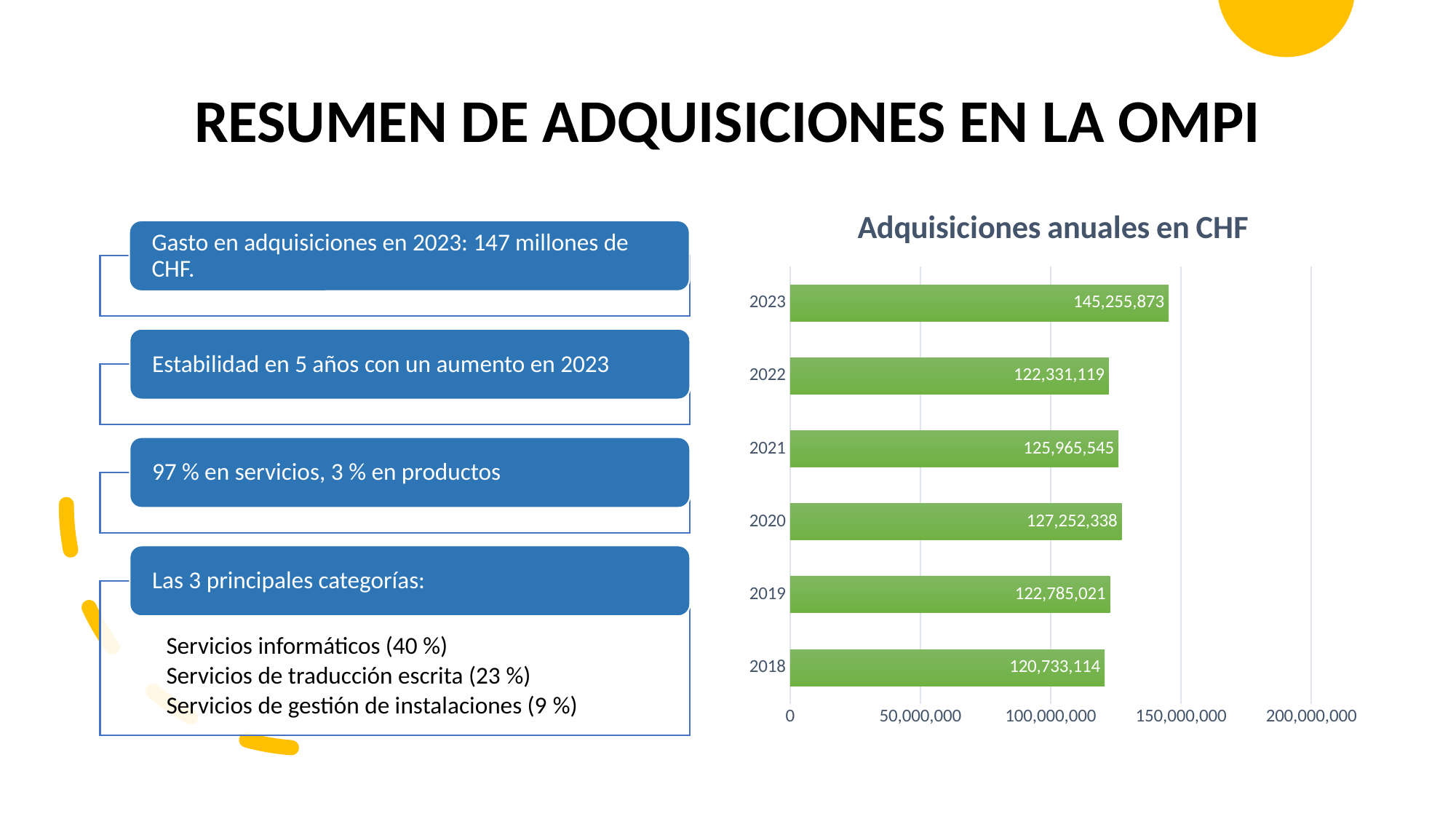
Which year has the lowest value in the "Adquisiciones anuales en CHF" chart? 2018 In the "Adquisiciones anuales en CHF" chart, which is larger, the value for 2021 or the value for 2019? 2021 What is the title of the chart on the slide? Adquisiciones anuales en CHF Which year has the highest value in the "Adquisiciones anuales en CHF" chart? 2023 What is the value for 2018 in the "Adquisiciones anuales en CHF" chart? 120,733,114 What is the difference between the 2023 and 2022 values in the "Adquisiciones anuales en CHF" chart? 22,924,754 How many years are shown in the "Adquisiciones anuales en CHF" chart? 6 What is the value for 2020 in the "Adquisiciones anuales en CHF" chart? 127,252,338 What type of chart is shown under the title "Adquisiciones anuales en CHF"? bar chart What is the difference between the 2020 and 2018 values in the "Adquisiciones anuales en CHF" chart? 6,519,224 What is the value for 2023 in the "Adquisiciones anuales en CHF" chart? 145,255,873 Is the value for 2023 in the "Adquisiciones anuales en CHF" chart greater or less than 150,000,000? less